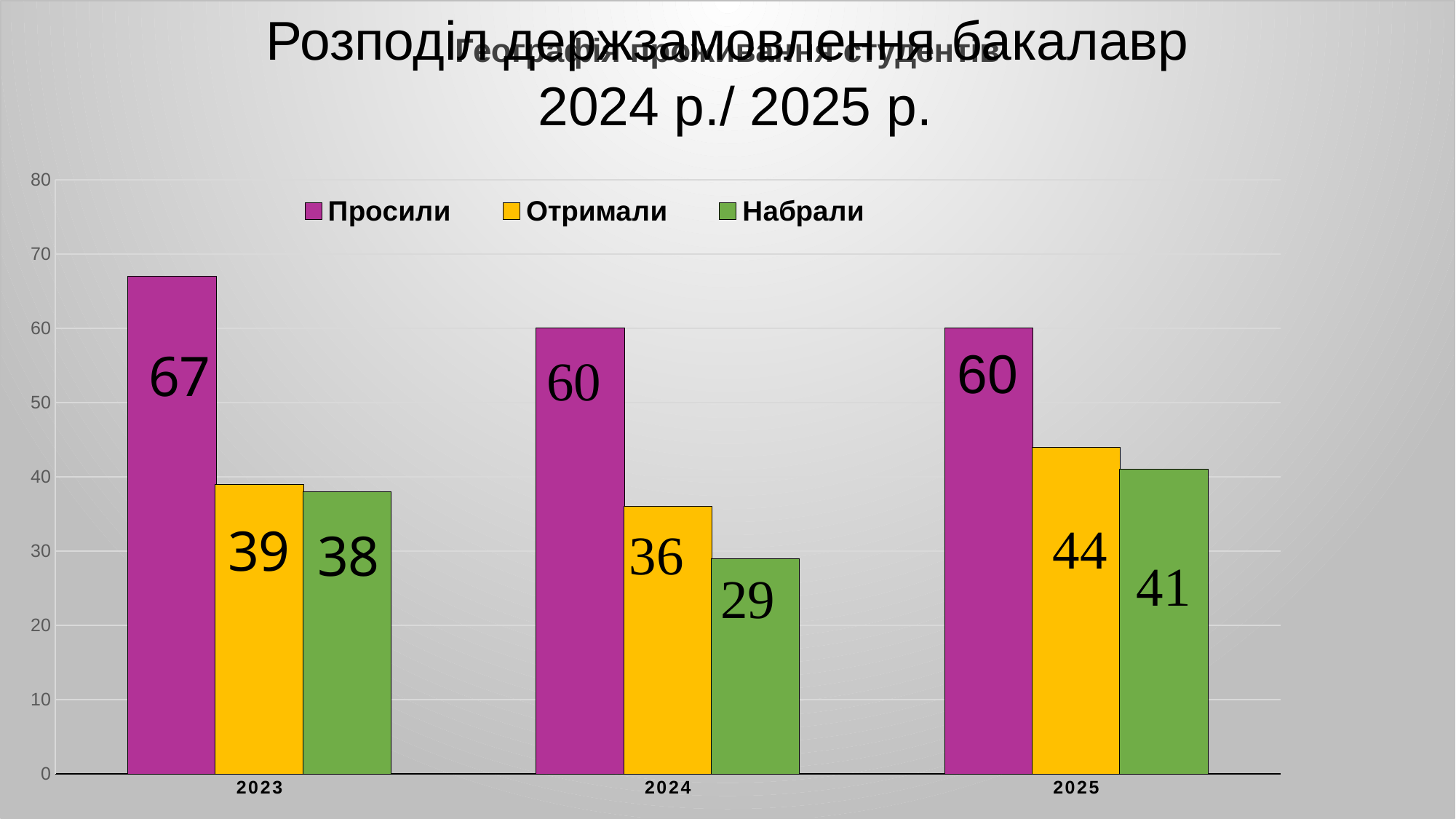
What is the value of Просили for 2023? 67 How many years are shown on the x axis? 3 Which colour represents the Набрали series in the legend? green In which year is the Просили value highest? 2023 In which year is the Набрали value lowest? 2024 What kind of chart is shown on the slide? bar chart What is the difference between Отримали and Набрали in 2024? 7 What is the difference between Просили and Отримали in 2023? 28 How many series does the legend list? 3 Which is larger in 2025: Отримали or Набрали? Отримали What is the value of Отримали for 2025? 44 What is the value of Набрали for 2024? 29